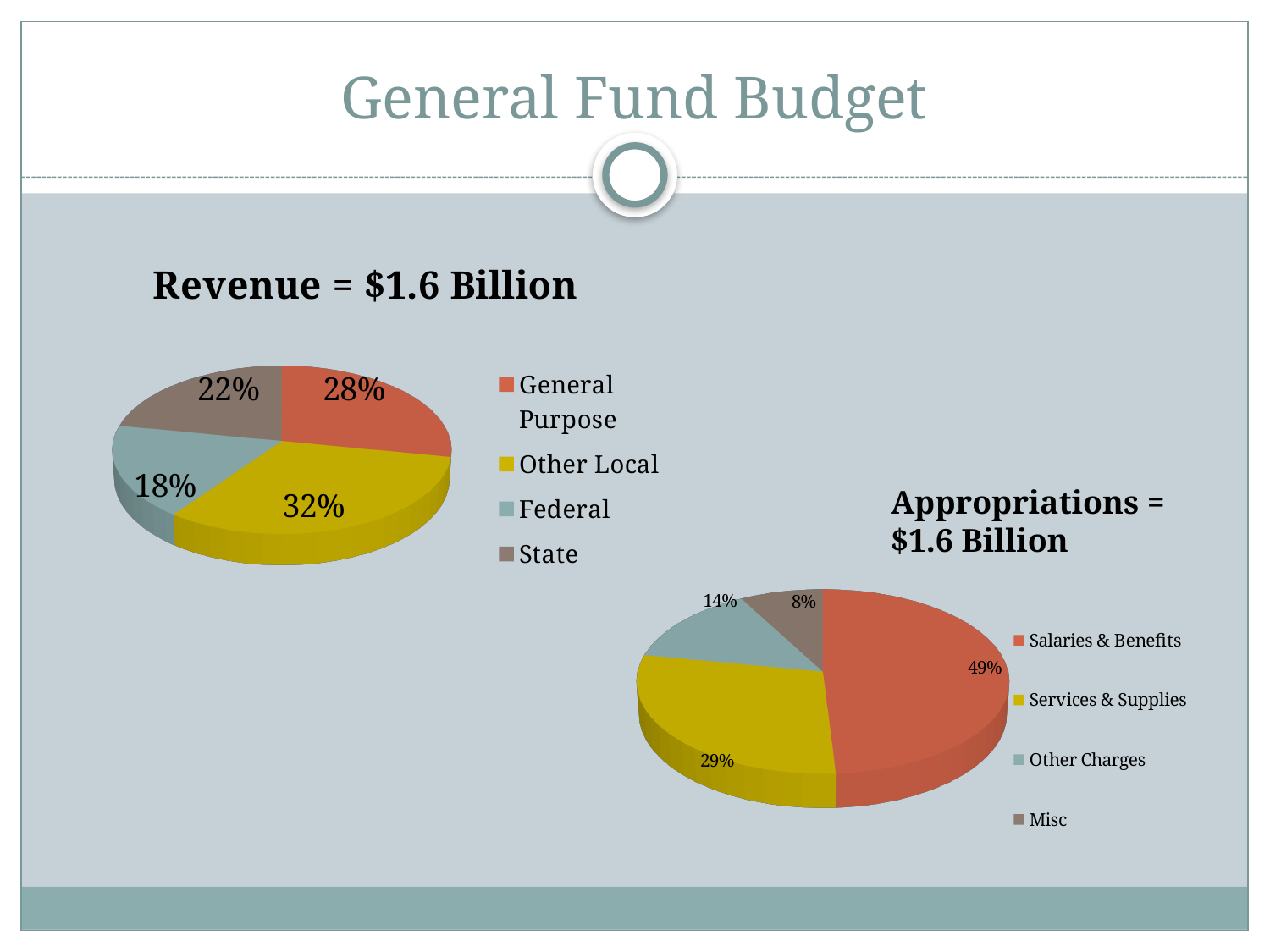
In the Appropriations pie chart, what share does Misc have? 8% In the Revenue pie chart, which category has the smallest share? Federal What type of chart is the Appropriations chart? Pie chart In the Appropriations pie chart, what is the difference between the Services & Supplies share and the Other Charges share? 15% In the Appropriations pie chart, which is larger, Services & Supplies or Other Charges? Services & Supplies In the Appropriations pie chart, what share does Salaries & Benefits have? 49% In the Revenue pie chart, what share does Federal have? 18% In the Revenue pie chart, what is the difference between the General Purpose share and the State share? 6% In the Revenue pie chart, how many categories are shown? 4 In the Appropriations pie chart, which category has the largest share? Salaries & Benefits In the Revenue pie chart, what share does Other Local have? 32% In the Revenue pie chart, which category has the largest share? Other Local